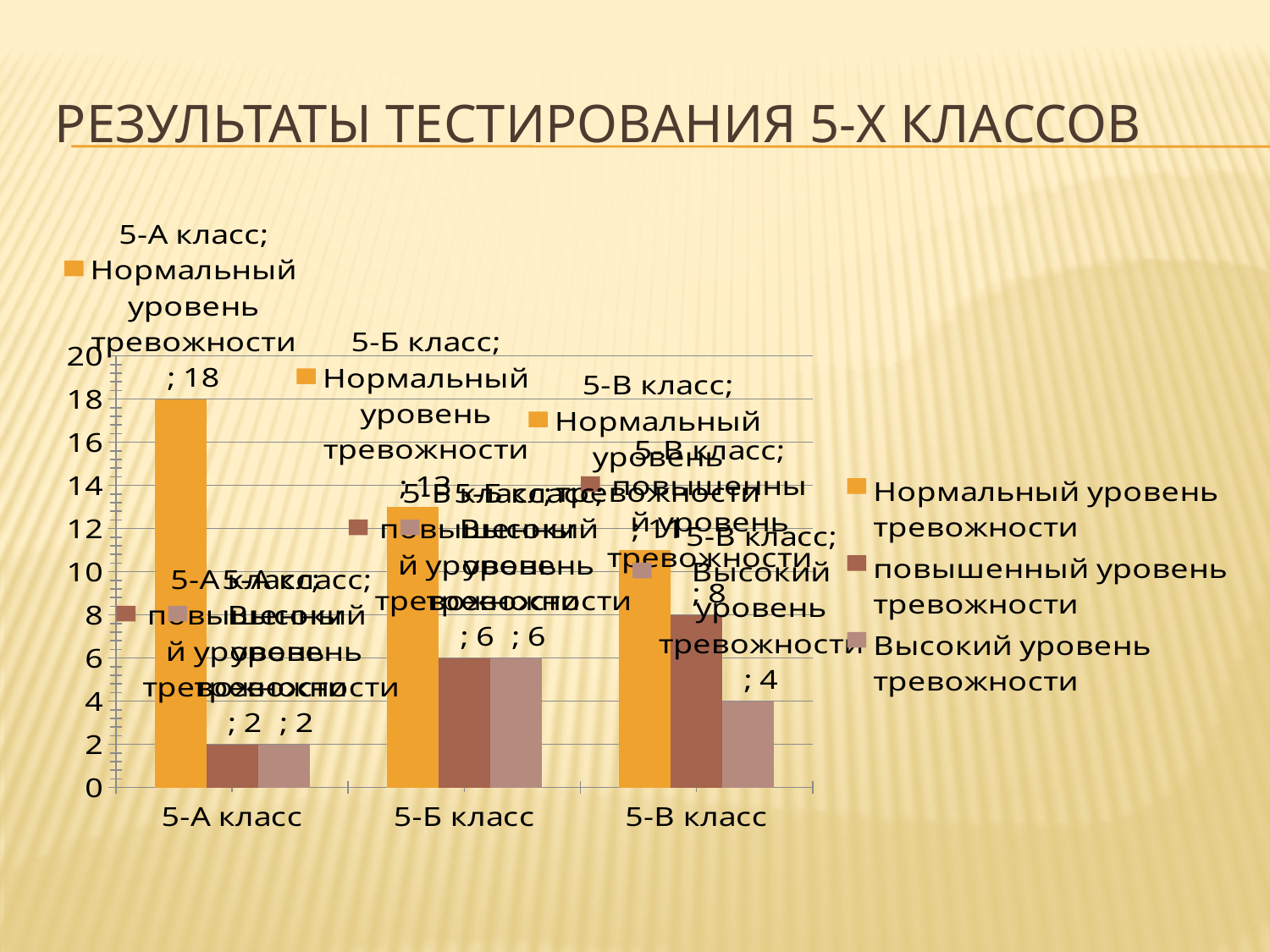
Which class has the lowest value for повышенный уровень тревожности? 5-А класс What is the value for Высокий уровень тревожности in 5-В класс? 4 What is the value for повышенный уровень тревожности in 5-В класс? 8 What is the value for Нормальный уровень тревожности in 5-Б класс? 13 How many series does the legend list? 3 What kind of chart is shown on the slide? bar chart Is the value for Нормальный уровень тревожности in 5-В класс greater or less than 14? less How many classes (categories) are shown on the x axis? 3 Which class has the highest value for Нормальный уровень тревожности? 5-А класс Which is larger: повышенный уровень тревожности in 5-Б класс or in 5-В класс? 5-В класс What is the value for Нормальный уровень тревожности in 5-А класс? 18 What is the difference between the Нормальный уровень тревожности values for 5-А класс and 5-Б класс? 5